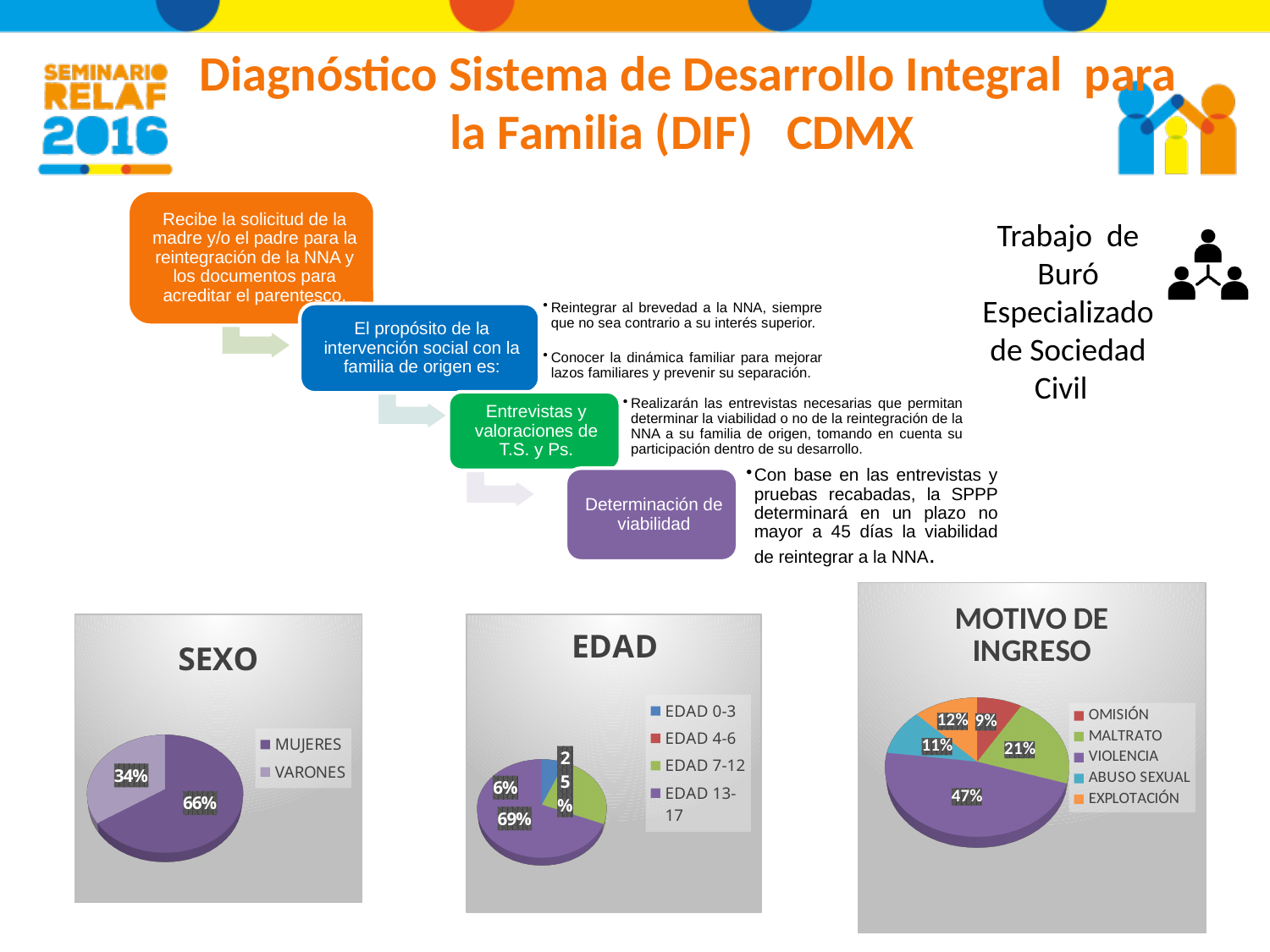
In the MOTIVO DE INGRESO chart, which category has the smallest share? OMISIÓN In the EDAD chart, what percentage is shown for EDAD 13-17? 69% In the EDAD chart, which age category has the largest share? EDAD 13-17 In the EDAD chart, how many age categories does the legend list? 4 In the MOTIVO DE INGRESO chart, how many categories does the legend list? 5 In the SEXO chart, what percentage is shown for MUJERES? 66% In the MOTIVO DE INGRESO chart, which is larger, ABUSO SEXUAL or EXPLOTACIÓN? EXPLOTACIÓN In the SEXO chart, what is the difference in percentage points between MUJERES and VARONES? 32 In the MOTIVO DE INGRESO chart, what percentage is shown for MALTRATO? 21% In the MOTIVO DE INGRESO chart, what percentage is shown for VIOLENCIA? 47% In the SEXO chart, what percentage is shown for VARONES? 34% What type of chart is the SEXO chart? Pie chart